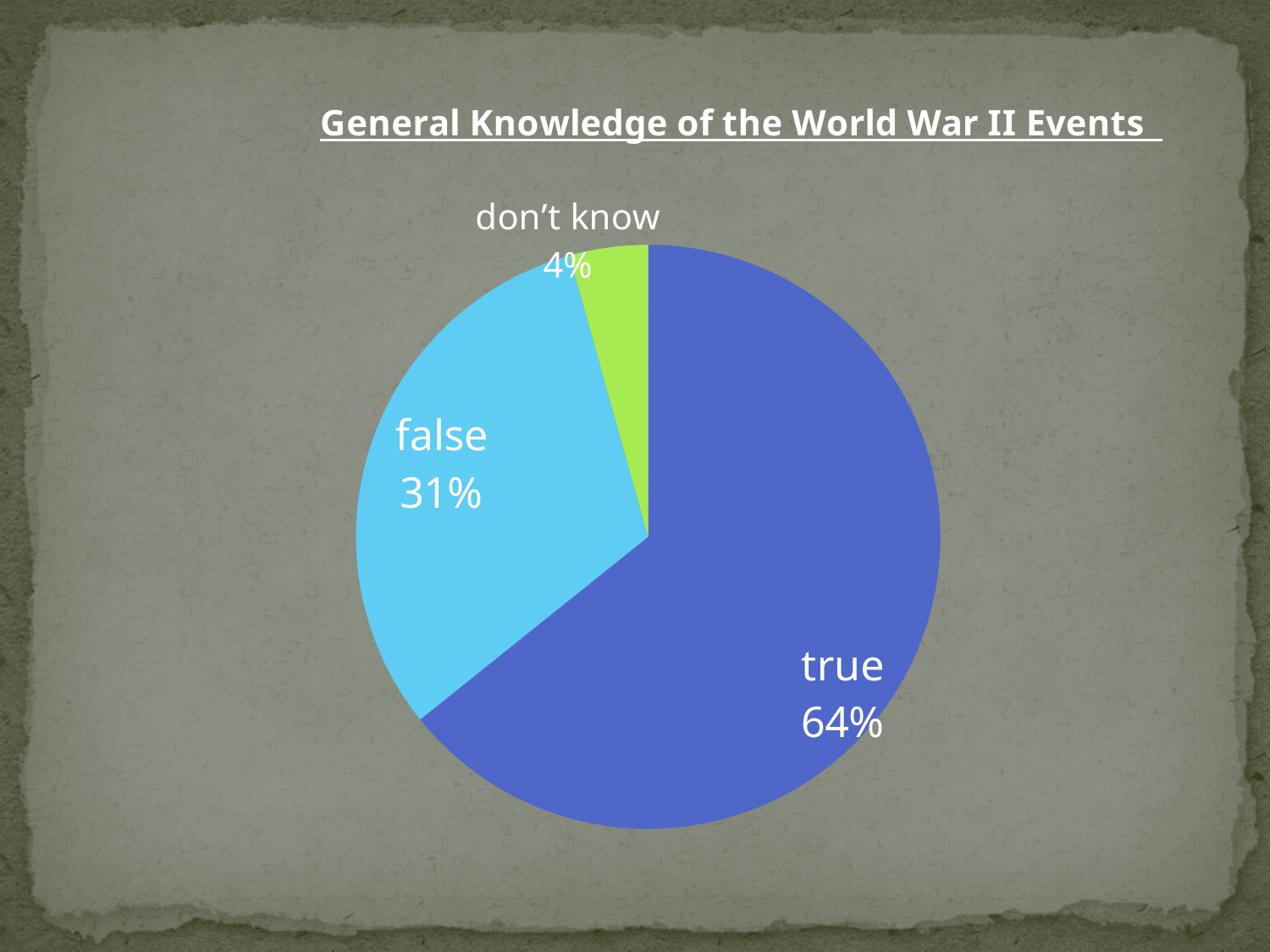
How many slices does the pie chart have? 3 What percentage of the pie is labelled "false"? 31% What colour is the "true" slice of the pie? blue Which is larger, the "false" slice or the "don't know" slice? false Which slice of the pie is the largest? true What is the title of the chart? General Knowledge of the World War II Events What is the difference in percentage points between the "true" and "false" slices? 33 What percentage of the pie is labelled "true"? 64% What percentage of the pie is labelled "don't know"? 4% What kind of chart is shown on the slide? pie chart Which slice of the pie is the smallest? don't know What is the difference in percentage points between the "false" and "don't know" slices? 27